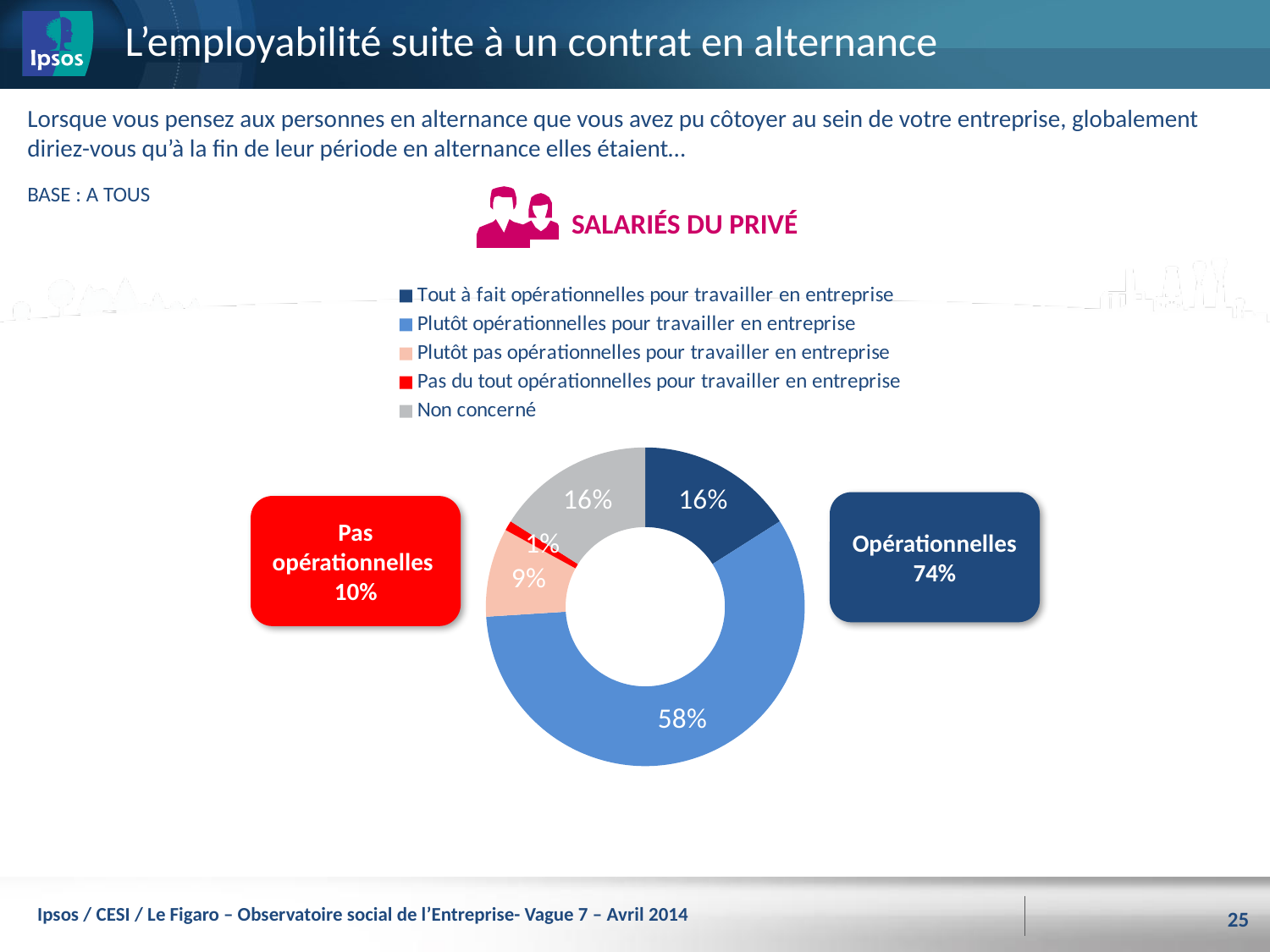
What percentage of respondents said the alternance workers were "Plutôt opérationnelles pour travailler en entreprise"? 58% According to the callout box on the right, what is the combined share of respondents who found the alternance workers "Opérationnelles"? 74% What percentage of respondents answered "Non concerné"? 16% Which response category has the largest share of the chart? Plutôt opérationnelles pour travailler en entreprise What percentage of respondents said the alternance workers were "Tout à fait opérationnelles pour travailler en entreprise"? 16% What percentage of respondents answered "Pas du tout opérationnelles pour travailler en entreprise"? 1% Which response category has the smallest share of the chart? Pas du tout opérationnelles pour travailler en entreprise What kind of chart is shown on the slide? Doughnut (pie) chart What percentage of respondents answered "Plutôt pas opérationnelles pour travailler en entreprise"? 9% How many response categories does the legend list? 5 What is the difference between the share for "Plutôt opérationnelles" and the share for "Tout à fait opérationnelles"? 42 percentage points Which is larger: the share for "Plutôt pas opérationnelles" or the share for "Non concerné"? Non concerné